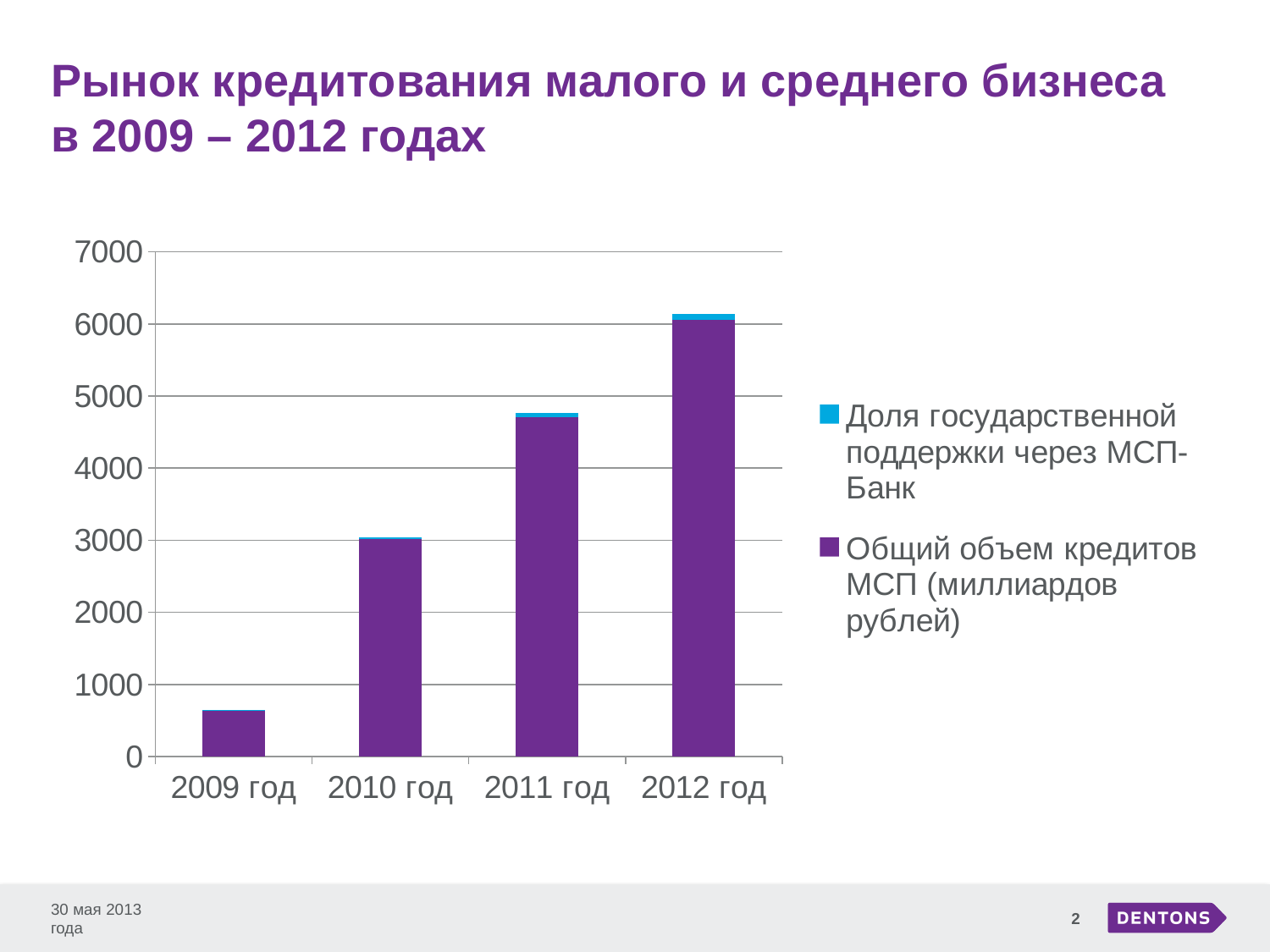
Which is larger, the total bar for 2010 год or the total bar for 2011 год? 2011 год Is the total bar for 2011 год greater or less than 5000? less Which year has the lowest total bar in the chart? 2009 год Which year has the highest total bar in the chart? 2012 год How many years (categories) are shown on the x axis of the chart? 4 How many series does the chart's legend list? 2 Is the total bar for 2009 год greater or less than 1000? less What kind of chart is shown on the slide? bar chart Do the total bar values rise or fall from 2009 год to 2012 год? rise Is the total bar for 2012 год greater or less than 6000? greater Which series is shown in purple in the chart's legend? Общий объем кредитов МСП (миллиардов рублей)